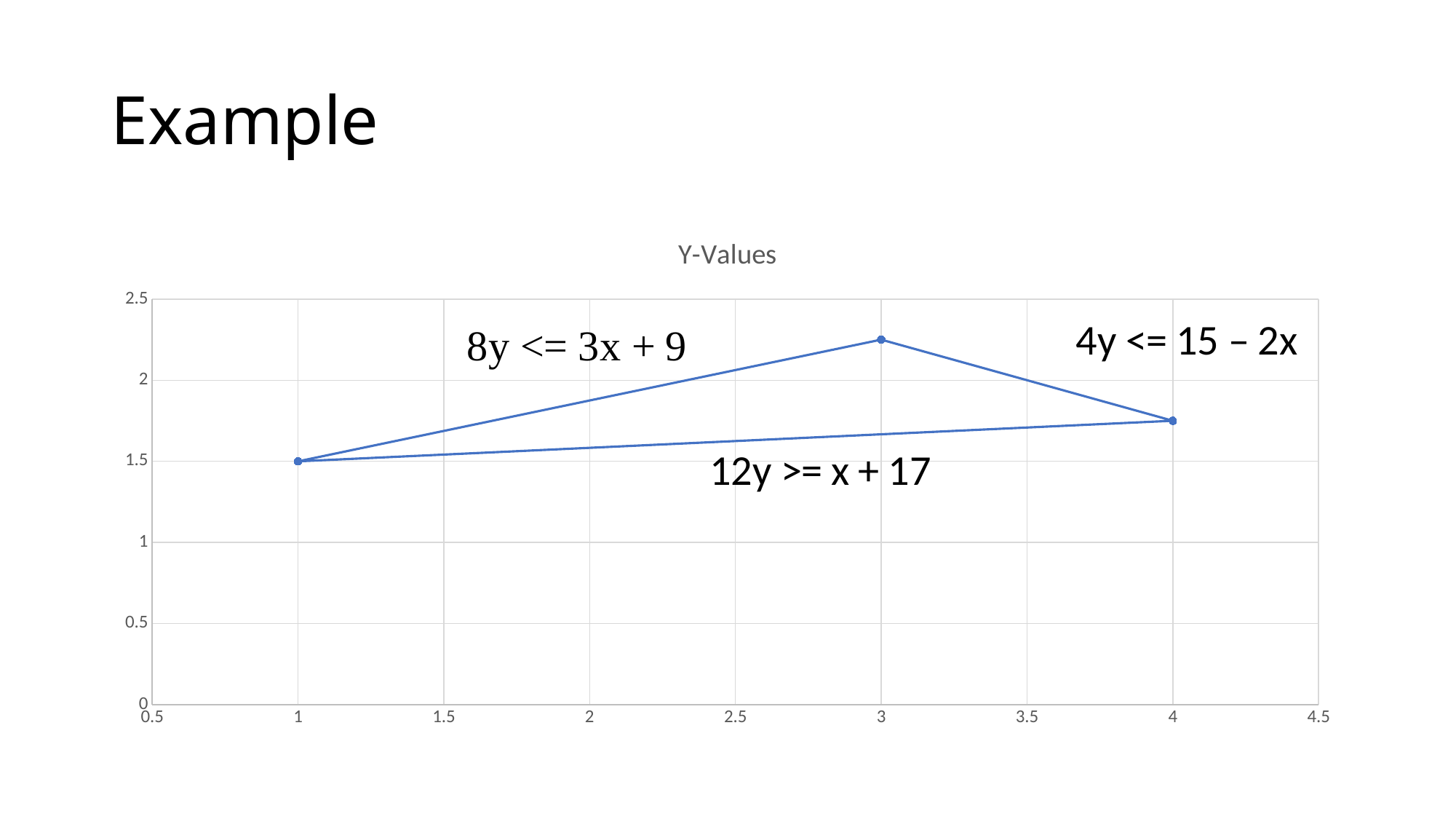
What kind of chart is shown on the slide? line chart What is the y value of the point plotted at x = 1? 1.5 What is the title of the chart? Y-Values Do the y values rise or fall from x = 1 to x = 3? rise At which x value does the plotted point have the lowest y value? 1 What inequality is written below the bottom edge of the triangle? 12y >= x + 17 How many data points (markers) are plotted on the chart? 3 Is the y value of the point at x = 4 greater or less than 1.5? greater Is the y value of the point at x = 4 greater or less than 2? less At which x value does the plotted point have the highest y value? 3 Which point has the larger y value, the one at x = 3 or the one at x = 4? x = 3 Is the y value of the point at x = 3 greater or less than 2? greater